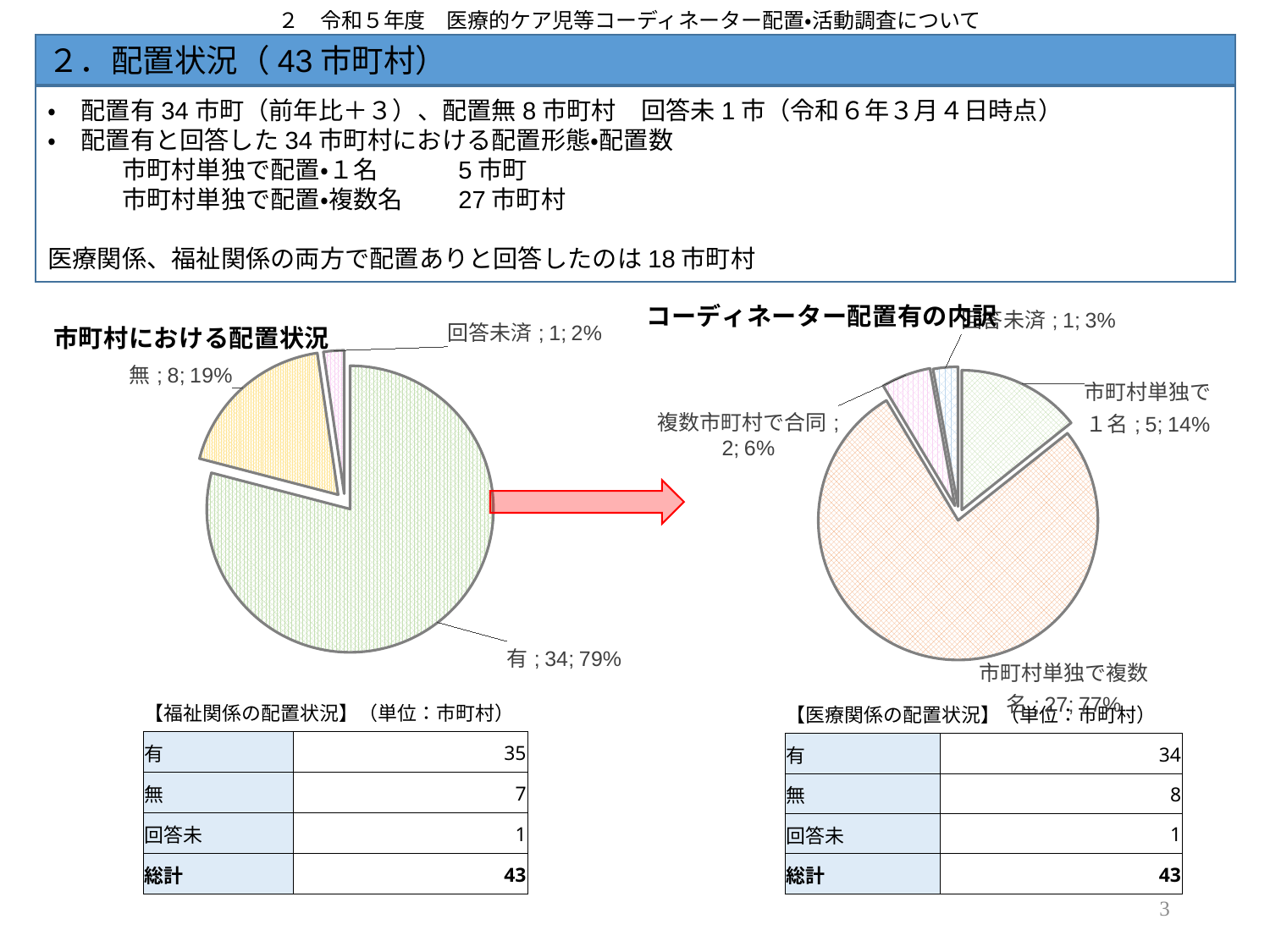
「市町村における配置状況」のグラフはどの種類のグラフですか？ 円グラフ 「市町村における配置状況」のグラフで、最も大きい区分はどれですか？ 有 「コーディネーター配置有の内訳」のグラフで、「市町村単独で複数名」の市町村数はいくつですか？ 27 「市町村における配置状況」のグラフで、「有」の市町村数はいくつですか？ 34 「コーディネーター配置有の内訳」のグラフで、「市町村単独で1名」と「複数市町村で合同」ではどちらが多いですか？ 市町村単独で1名 「市町村における配置状況」のグラフには区分がいくつありますか？ 3 「コーディネーター配置有の内訳」のグラフには区分がいくつありますか？ 4 「市町村における配置状況」のグラフで、「無」の割合は何％ですか？ 19% 「コーディネーター配置有の内訳」のグラフで、「市町村単独で1名」と「複数市町村で合同」の市町村数の差はいくつですか？ 3 「市町村における配置状況」のグラフで、最も小さい区分はどれですか？ 回答未済 「コーディネーター配置有の内訳」のグラフで、「複数市町村で合同」の割合は何％ですか？ 6% 「市町村における配置状況」のグラフで、「有」と「無」の市町村数の差はいくつですか？ 26